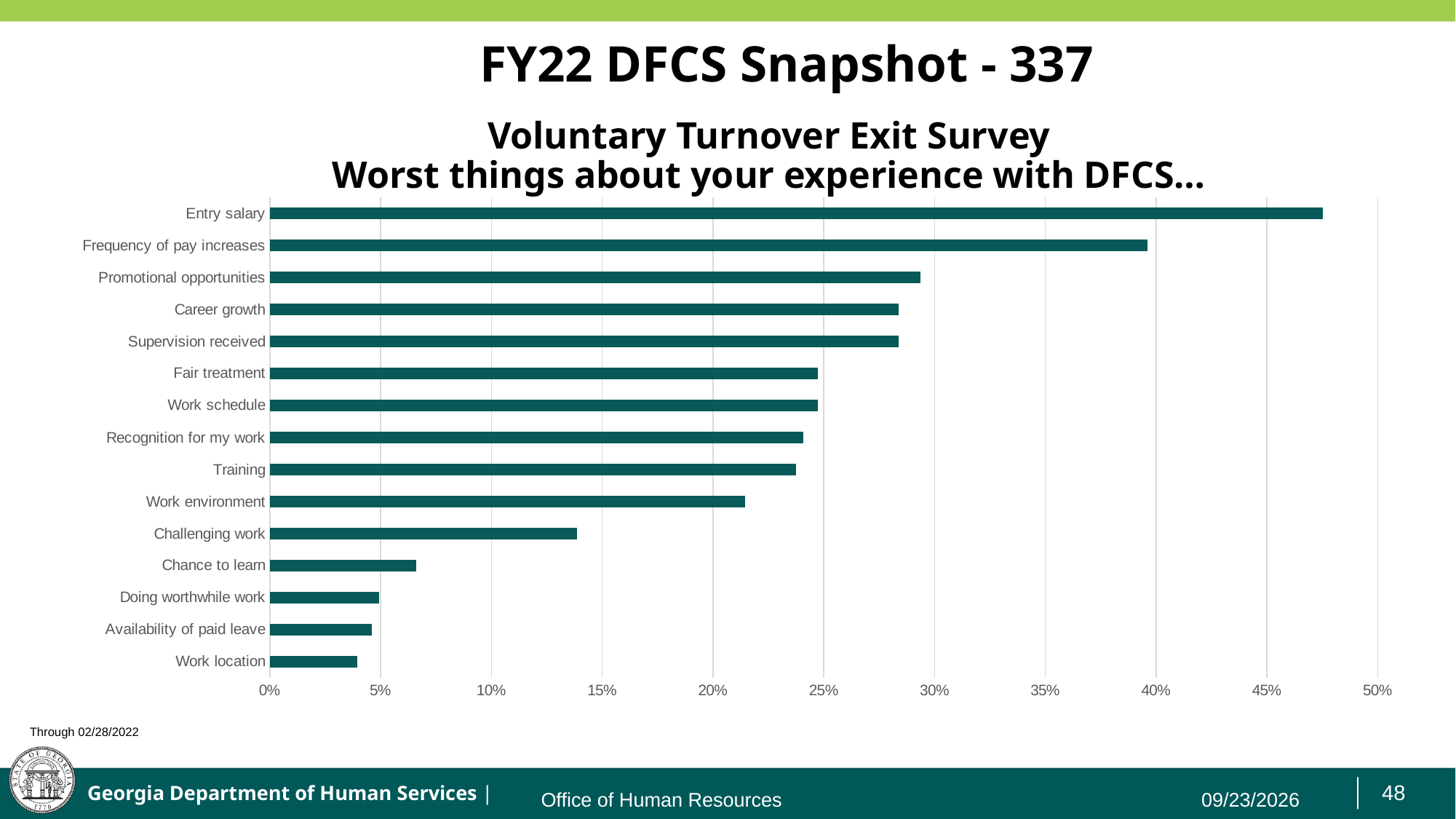
Is the value for Work environment greater or less than 20%? greater Which category has the highest value in the chart? Entry salary What is the title of the chart? Voluntary Turnover Exit Survey Worst things about your experience with DFCS... Is the value for Chance to learn greater or less than 5%? greater Is the value for Challenging work greater or less than 15%? less Which category has the lowest value in the chart? Work location How many categories are plotted in the chart? 15 Which is larger, the value for Entry salary or the value for Frequency of pay increases? Entry salary What kind of chart is shown on the slide? bar chart